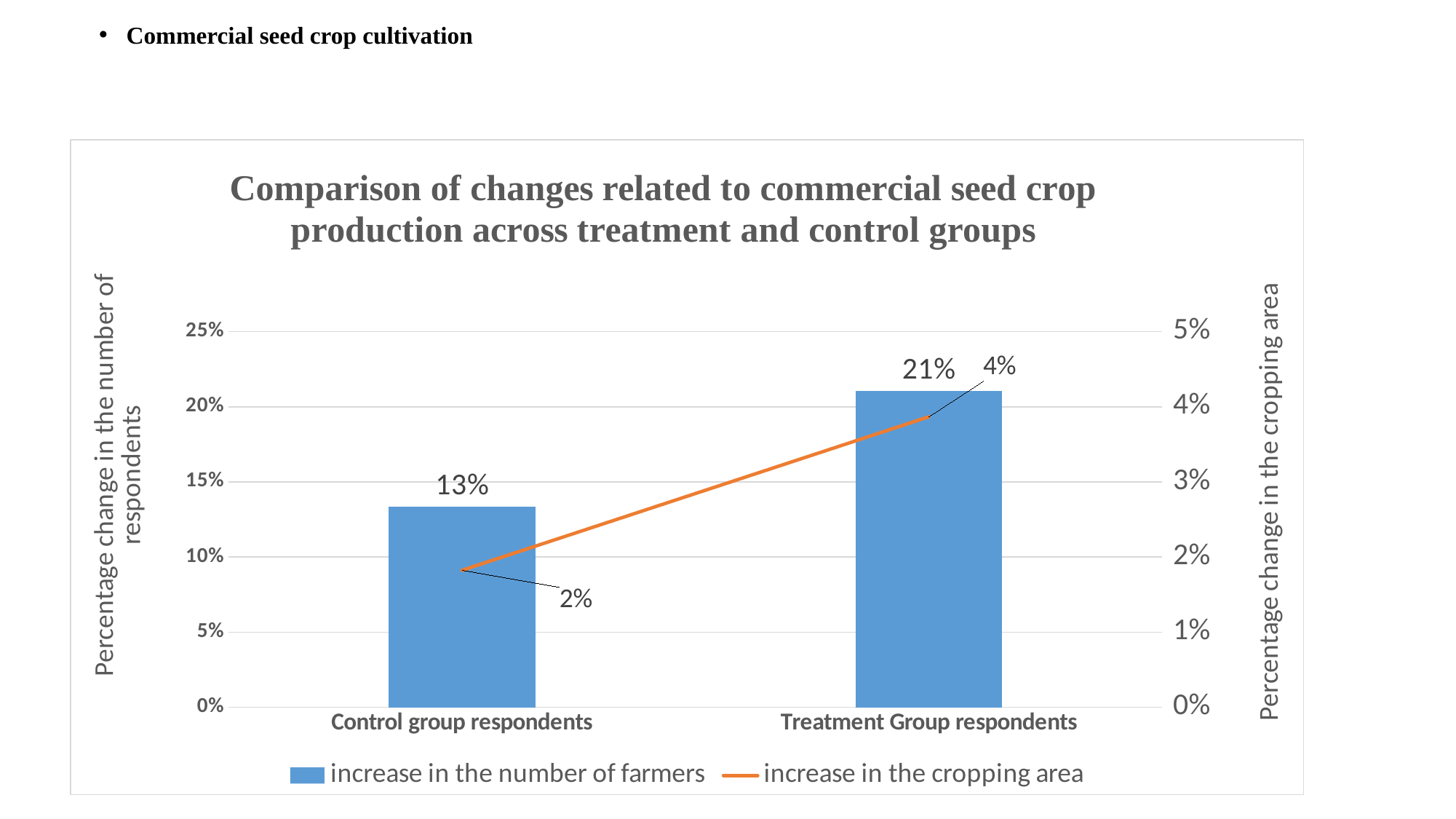
Is the 'increase in the number of farmers' bar for Treatment Group respondents greater or less than 20%? greater What is the value for 'increase in the number of farmers' for Treatment Group respondents? 21% What is the value for 'increase in the cropping area' for Control group respondents? 2% What is the value for 'increase in the number of farmers' for Control group respondents? 13% What is the difference in 'increase in the number of farmers' between Treatment Group respondents and Control group respondents? 8% Which group has the higher value for 'increase in the number of farmers'? Treatment Group respondents How many categories are shown on the x axis? 2 What is the title of the chart? Comparison of changes related to commercial seed crop production across treatment and control groups Which group has the lower value for 'increase in the cropping area'? Control group respondents What is the difference in 'increase in the cropping area' between Treatment Group respondents and Control group respondents? 2% What is the value for 'increase in the cropping area' for Treatment Group respondents? 4% How many series does the legend list? 2